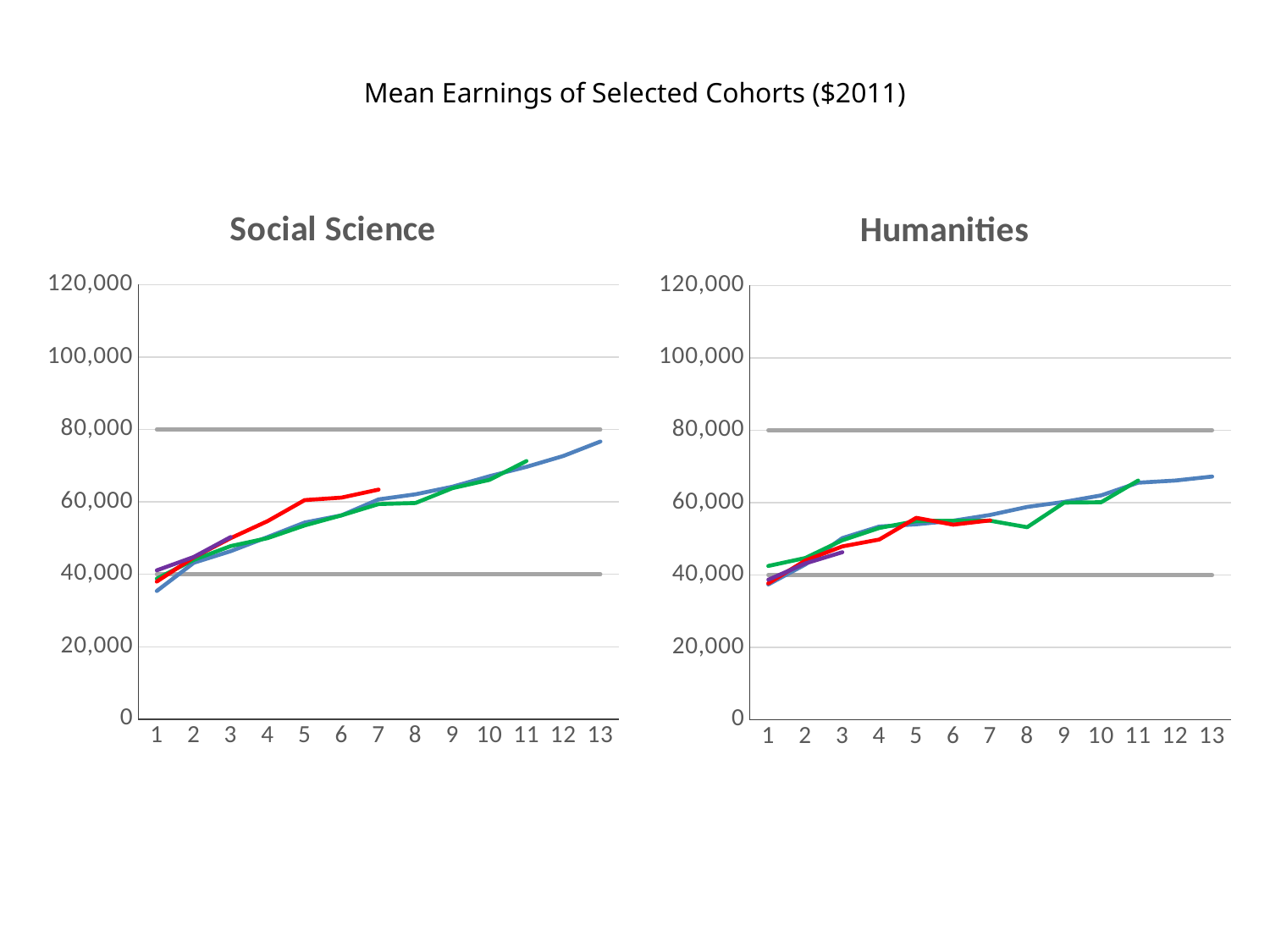
In the Humanities chart, is the value of the green line at x = 8 greater or less than 60,000? less What kind of chart is the Social Science chart? line chart In the Social Science chart, does the blue line rise or fall from x = 1 to x = 13? rise In the Social Science chart, is the value of the blue line at x = 13 greater or less than 80,000? less In the Humanities chart, does the blue line rise or fall from x = 1 to x = 13? rise What is the highest value labelled on the y axis of the Humanities chart? 120,000 How many points are labelled on the x axis of the Humanities chart? 13 In the Social Science chart, is the value of the blue line at x = 1 greater or less than 40,000? less How many points are labelled on the x axis of the Social Science chart? 13 What kind of chart is the Humanities chart? line chart What is the overall title shown at the top of the slide? Mean Earnings of Selected Cohorts ($2011)